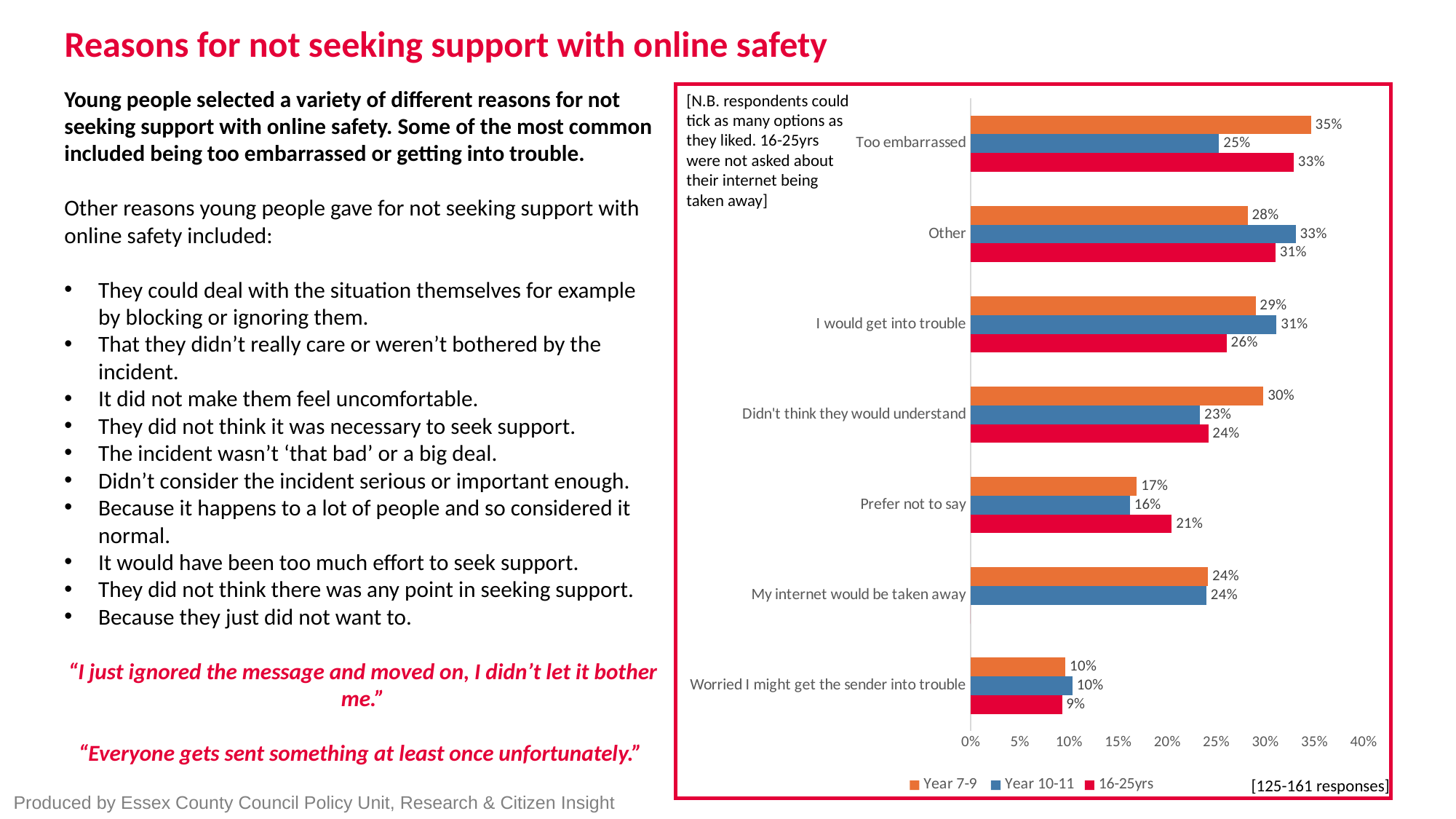
What percentage of 16-25yrs respondents selected 'Prefer not to say'? 21% What percentage of Year 7-9 respondents selected 'Too embarrassed' as a reason for not seeking support? 35% What percentage of Year 10-11 respondents selected 'Didn't think they would understand'? 23% How many series does the chart legend list? 3 Which group is not shown for 'My internet would be taken away'? 16-25yrs Which reason has the lowest value for 16-25yrs respondents? Worried I might get the sender into trouble How many reasons (categories) are shown on the chart? 7 What is the difference between the Year 7-9 and Year 10-11 values for 'Too embarrassed'? 10% Which colour represents the 16-25yrs series in the chart? Red What kind of chart is shown on the slide? Bar chart Which reason has the highest value for Year 7-9 respondents? Too embarrassed For 'I would get into trouble', which group has the larger value: Year 10-11 or 16-25yrs? Year 10-11